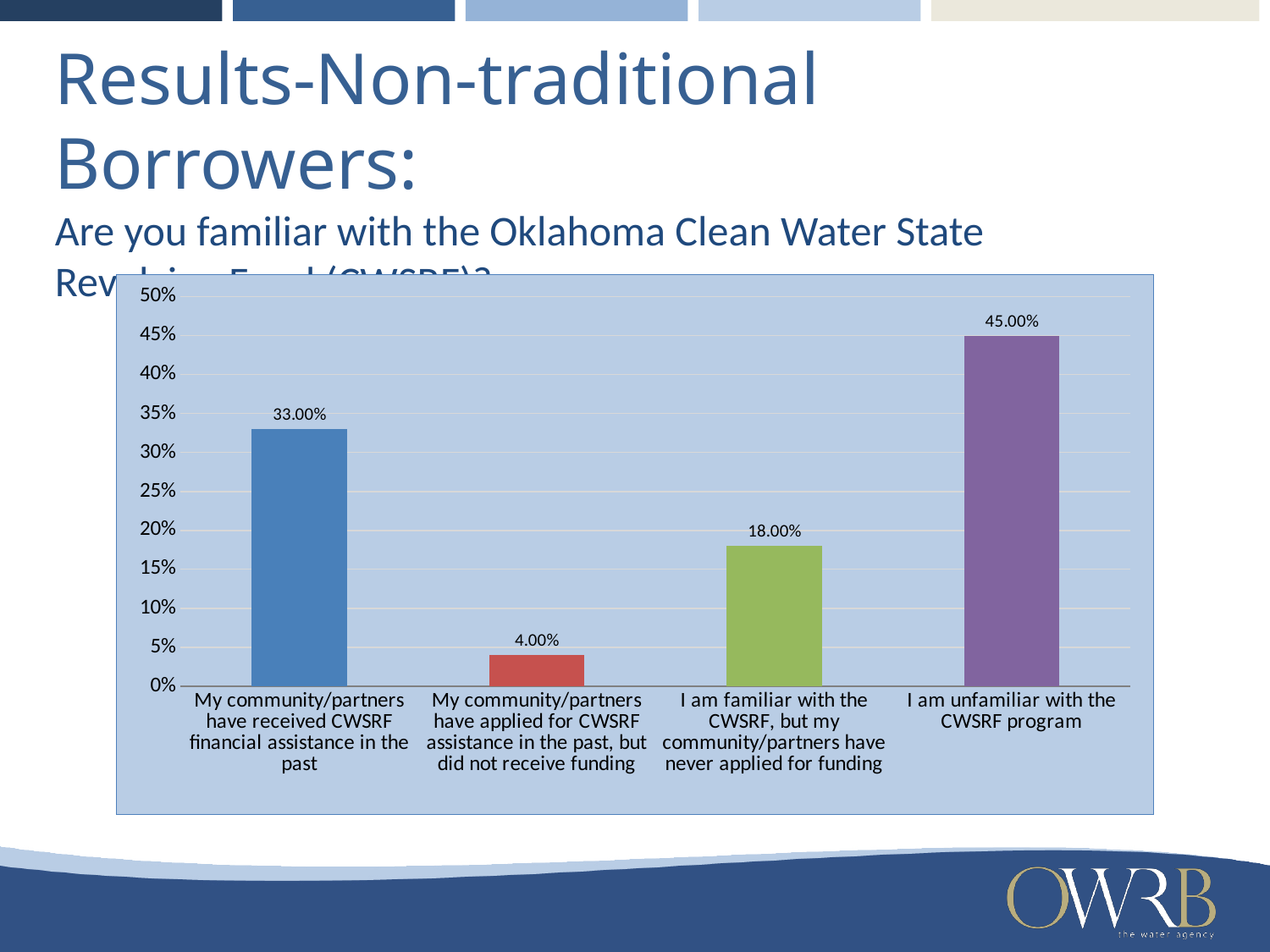
What percentage of respondents said they are unfamiliar with the CWSRF program? 45.00% What percentage of respondents said they are familiar with the CWSRF but their community/partners have never applied for funding? 18.00% What type of chart is shown on the slide? Bar chart What percentage of respondents said their community/partners have applied for CWSRF assistance in the past but did not receive funding? 4.00% Which response category has the lowest percentage? My community/partners have applied for CWSRF assistance in the past, but did not receive funding What is the maximum value shown on the vertical axis of the chart? 50% Is the value for 'I am unfamiliar with the CWSRF program' greater or less than 40%? greater Which is larger: the percentage who are familiar with the CWSRF but have never applied for funding, or the percentage whose community/partners have received CWSRF financial assistance in the past? My community/partners have received CWSRF financial assistance in the past Which response category has the highest percentage? I am unfamiliar with the CWSRF program How many response categories are shown in the chart? 4 What is the difference in percentage points between those unfamiliar with the CWSRF program and those whose community/partners have received CWSRF financial assistance in the past? 12.00% What percentage of respondents said their community/partners have received CWSRF financial assistance in the past? 33.00%